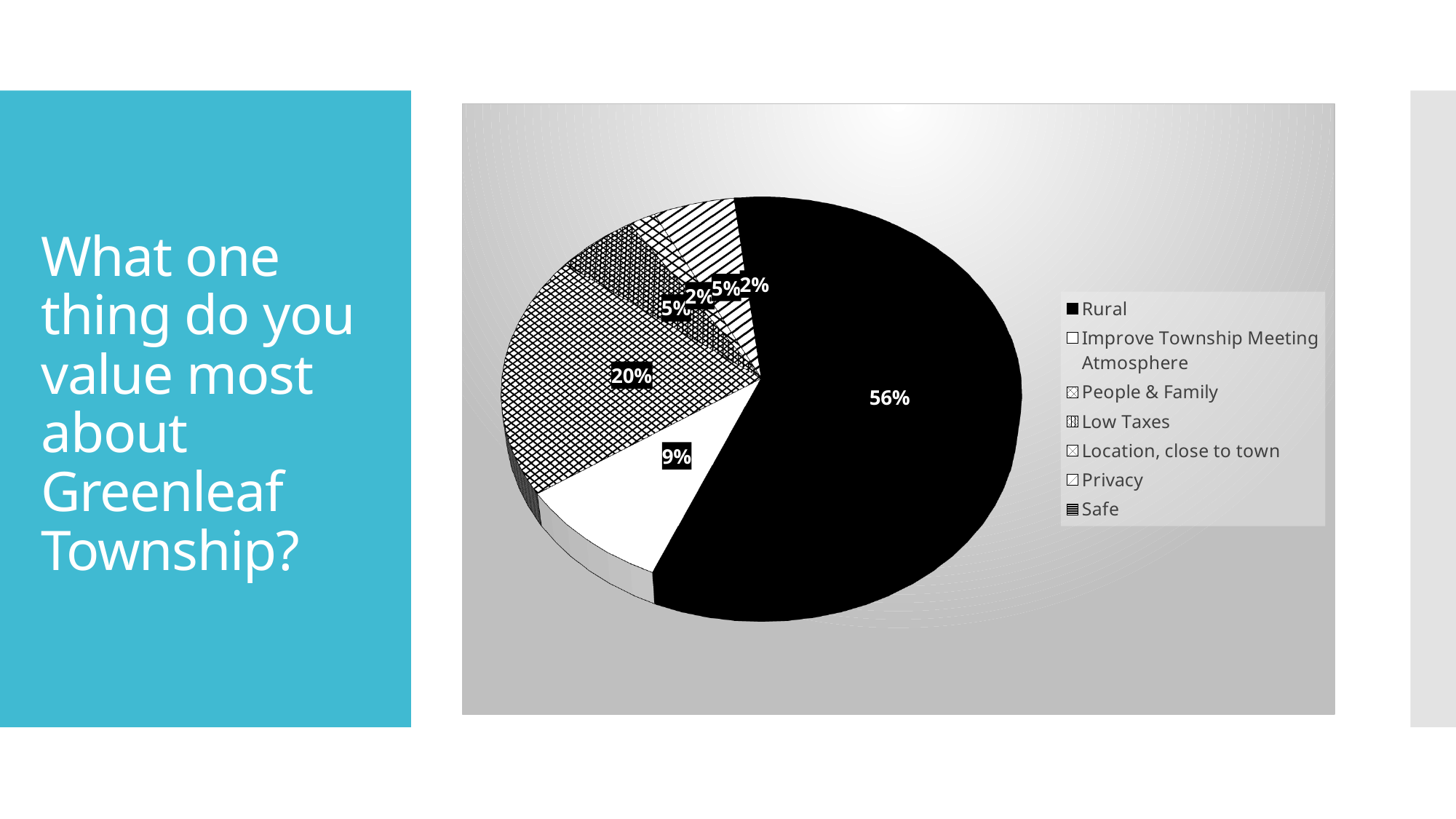
How many entries does the legend list? 7 What is the difference between the People & Family share and the Improve Township Meeting Atmosphere share? 11% What share of the pie does Rural account for? 56% What is the value for Improve Township Meeting Atmosphere? 9% Which is larger, People & Family or Improve Township Meeting Atmosphere? People & Family What is the value for People & Family? 20% Which category has the largest slice of the pie? Rural What is the difference between the Rural share and the People & Family share? 36% What kind of chart is shown on the slide? Pie chart How many categories does the pie chart have? 7 What question does the slide title ask? What one thing do you value most about Greenleaf Township? What is the value for Low Taxes? 5%